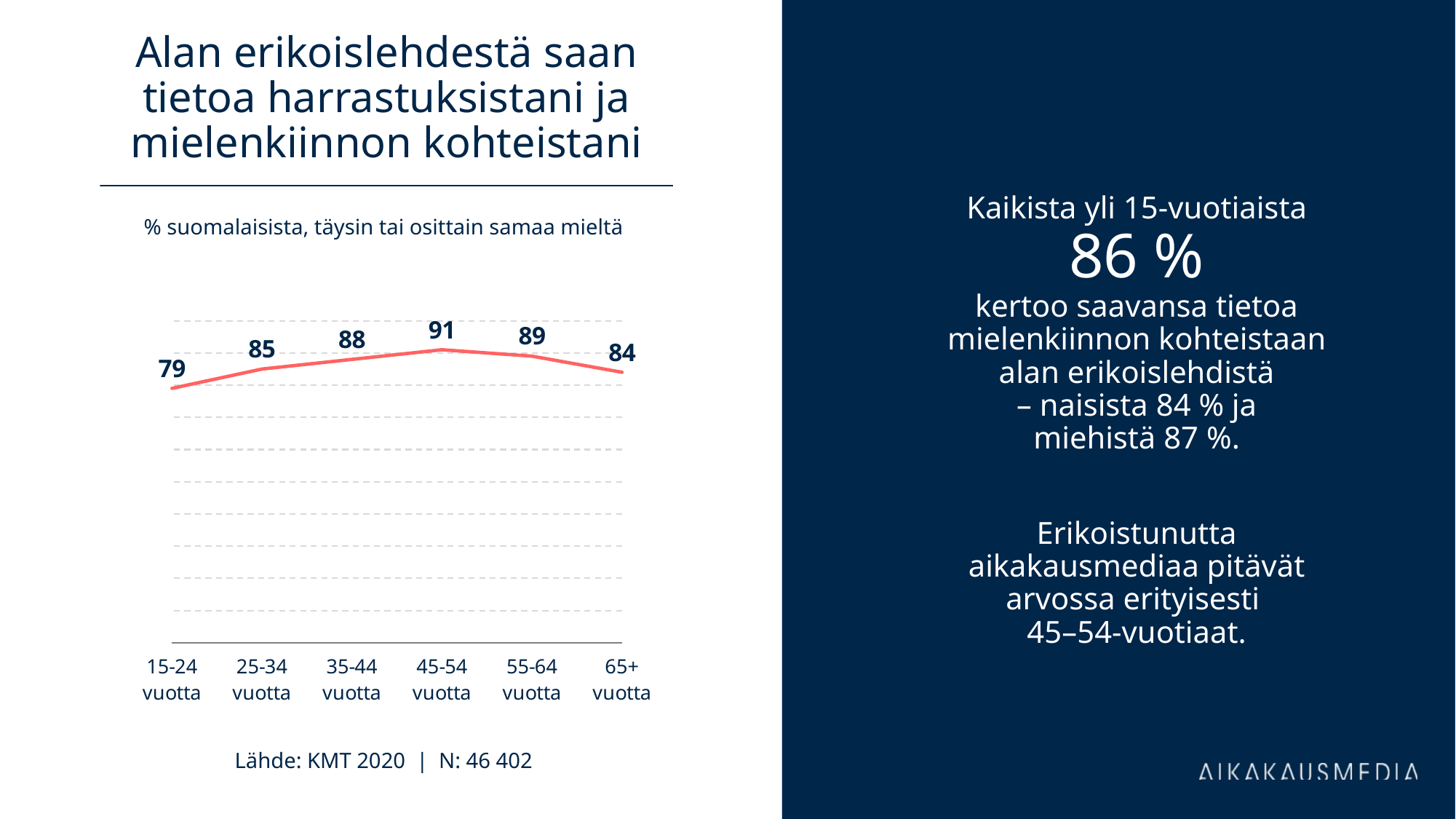
Do the values rise or fall from 15-24 vuotta to 45-54 vuotta? rise What is the value for the 45-54 vuotta age group? 91 How many age groups are shown on the x axis? 6 What is the difference between the values for 45-54 vuotta and 15-24 vuotta? 12 Which age group has the lowest value? 15-24 vuotta What is the subtitle text shown above the chart? % suomalaisista, täysin tai osittain samaa mieltä Which is larger, the value for 25-34 vuotta or the value for 35-44 vuotta? 35-44 vuotta Which age group has the highest value? 45-54 vuotta What is the value for the 15-24 vuotta age group? 79 What kind of chart is shown on the slide? line chart What is the difference between the values for 55-64 vuotta and 65+ vuotta? 5 What is the value for the 65+ vuotta age group? 84